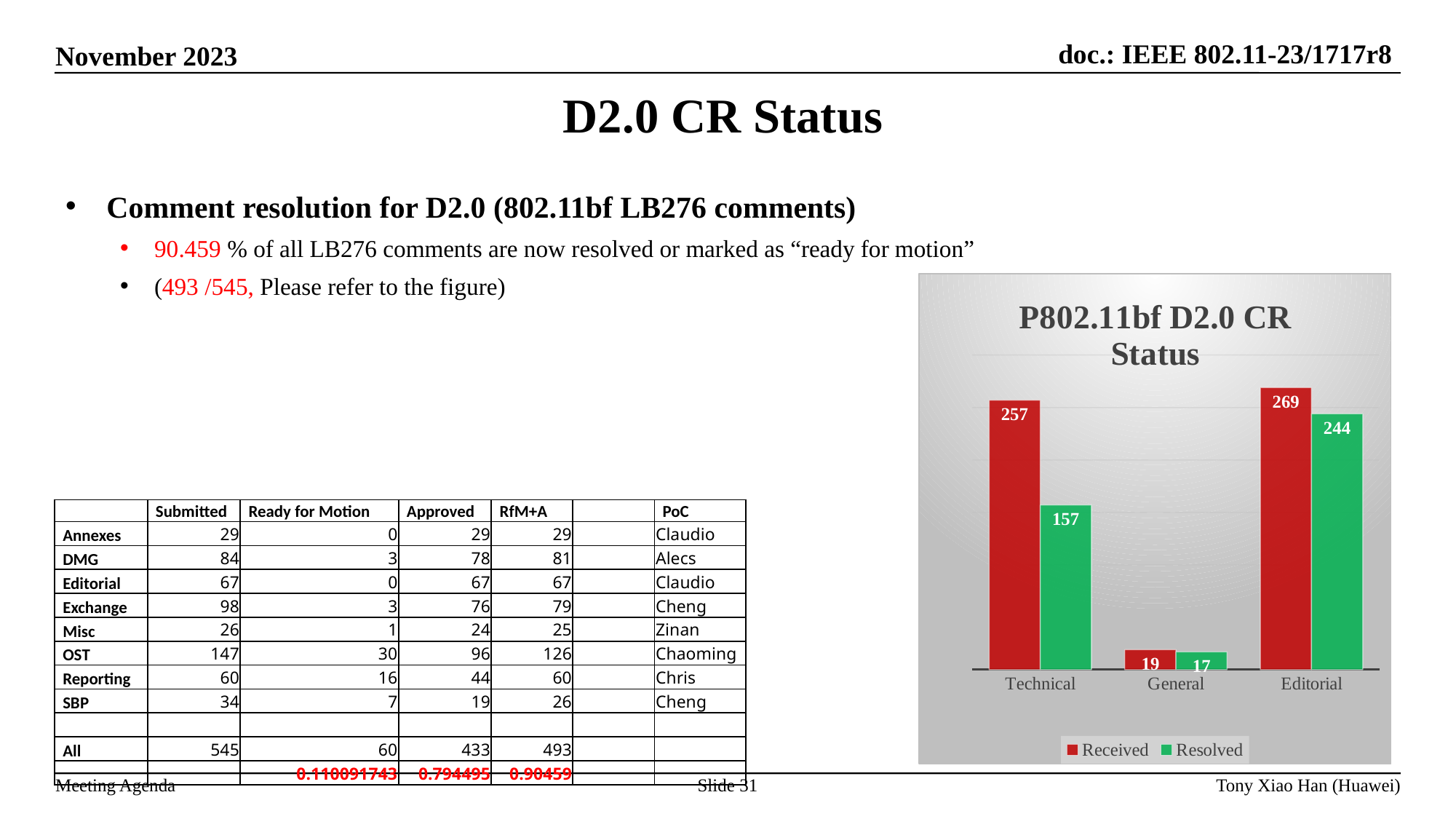
How many categories are shown on the x axis of the chart? 3 What is the Received value for Technical? 257 What is the difference between Received and Resolved for Technical? 100 What is the Resolved value for Editorial? 244 Which is larger, the Resolved value for Technical or the Resolved value for Editorial? Editorial What is the Resolved value for General? 17 Which category has the lowest Resolved value? General What is the title of the chart on the slide? P802.11bf D2.0 CR Status Which category has the highest Received value? Editorial How many series does the chart legend list? 2 What type of chart is shown on the slide? bar chart Which colour represents the Resolved series in the chart? green